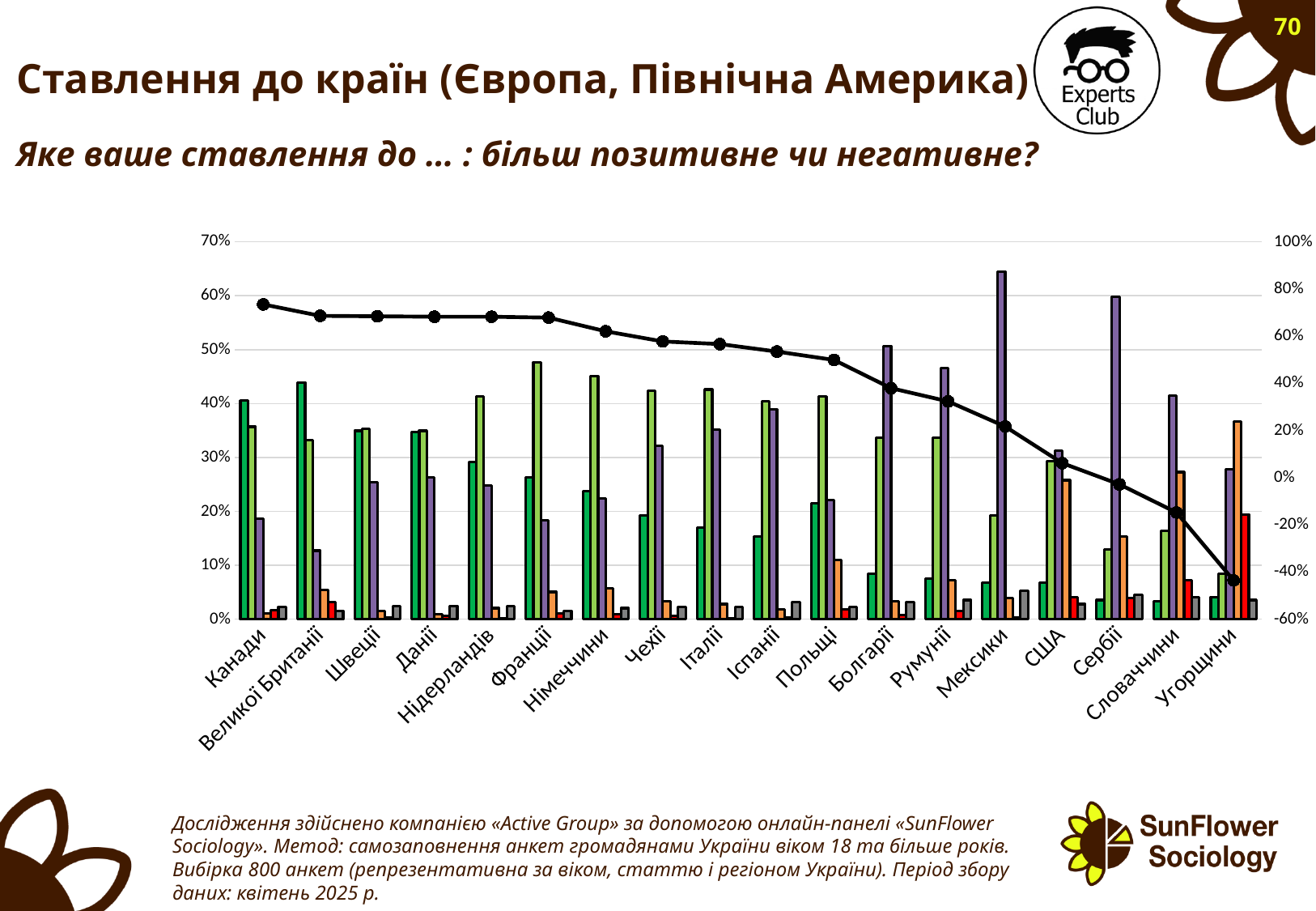
Is the purple bar for Мексики taller than the purple bar for Сербії? Yes, Мексики Is the black line value for Канади (right axis) greater or less than 60%? greater Does the black line rise or fall from left to right across the chart? It falls For which country is the black line at its lowest point? Угорщини For which country is the black line at its highest point? Канади Is the black line value for Угорщини (right axis) greater or less than -20%? less Which country has the tallest orange bar? Угорщини How many countries are shown along the x axis of the chart? 18 What kind of chart is shown on the slide? A bar chart combined with a line Which country has the tallest purple bar? Мексики Is the purple bar for Мексики (left axis) greater or less than 60%? greater What is the highest value shown on the left vertical axis? 70%